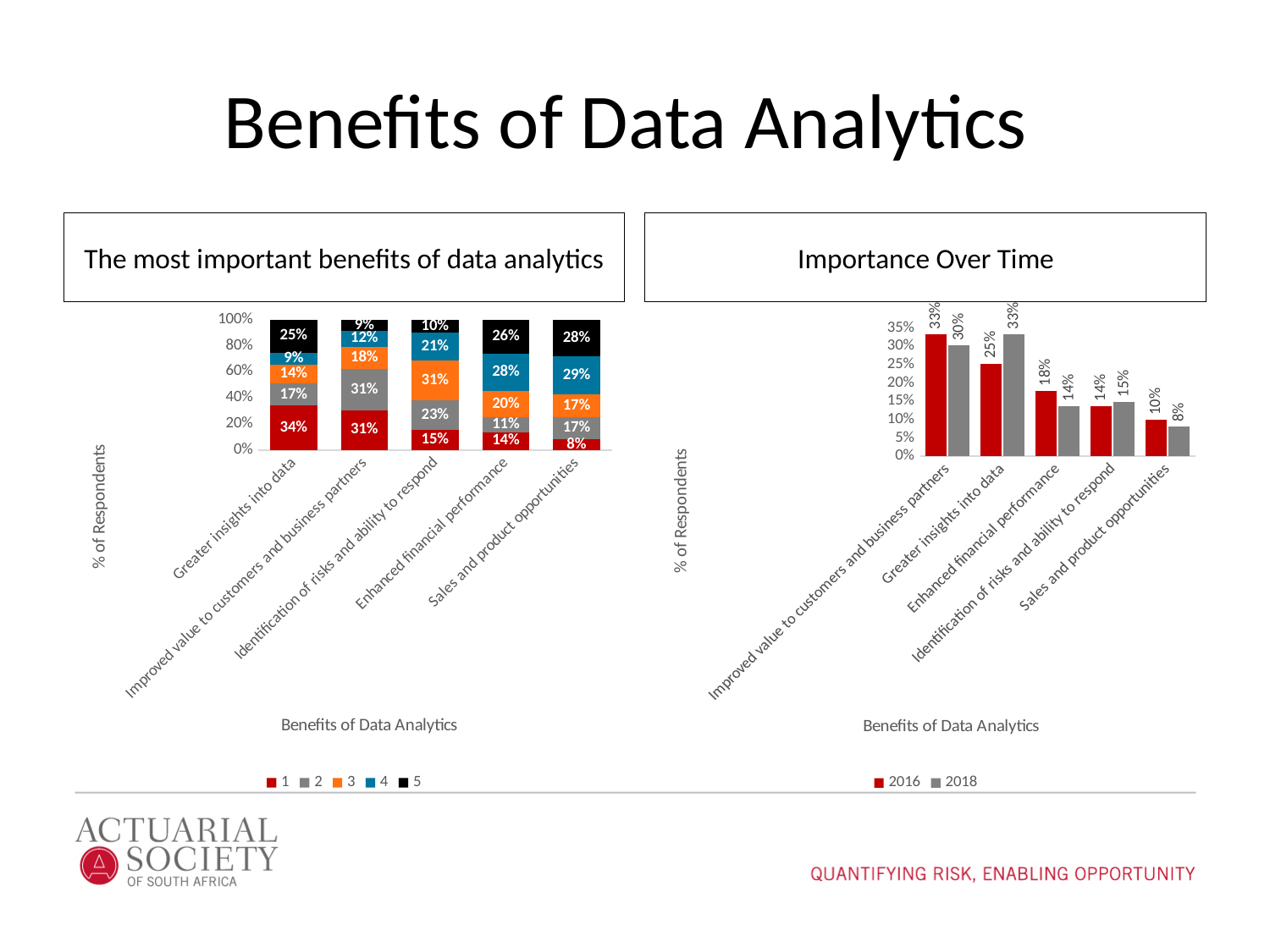
How many series does the legend of the 'Importance Over Time' chart list? 2 In the 'Importance Over Time' chart, what is the 2018 value for Greater insights into data? 33% In the 'Importance Over Time' chart, what is the difference between the 2016 and 2018 values for Enhanced financial performance? 4% What type of chart is 'The most important benefits of data analytics'? Stacked bar chart In the 'Importance Over Time' chart, is the 2016 value for Greater insights into data larger or smaller than its 2018 value? smaller In the 'Importance Over Time' chart, what is the 2016 value for Improved value to customers and business partners? 33% In the chart 'The most important benefits of data analytics', what is the value of series 3 for Identification of risks and ability to respond? 31% How many categories are shown on the x axis of the chart 'The most important benefits of data analytics'? 5 How many series does the legend of the chart 'The most important benefits of data analytics' list? 5 In the 'Importance Over Time' chart, which category has the lowest 2018 value? Sales and product opportunities In the chart 'The most important benefits of data analytics', which category has the lowest series 1 value? Sales and product opportunities In the chart 'The most important benefits of data analytics', what is the value of series 1 for Greater insights into data? 34%